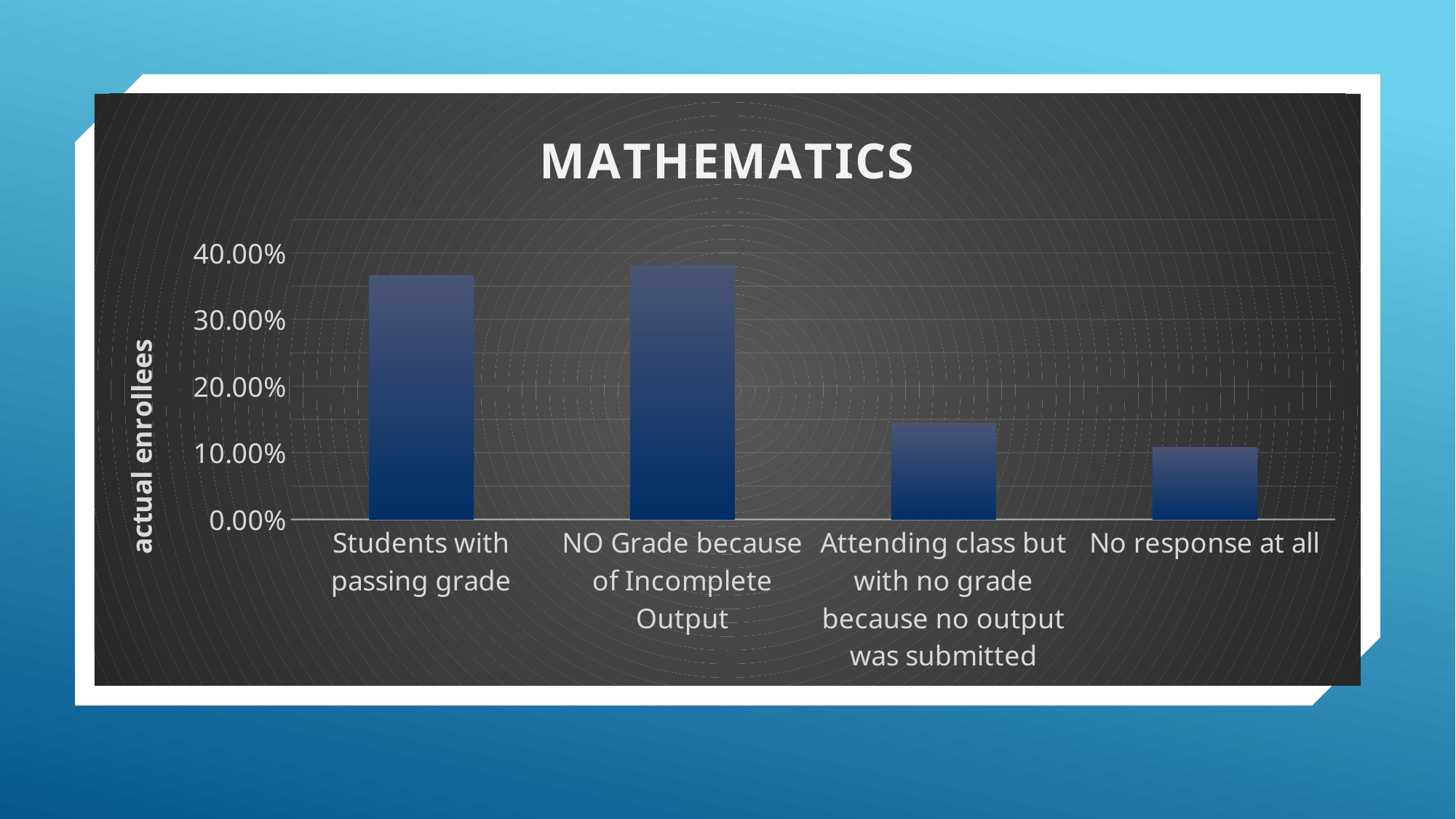
Is the value for Students with passing grade greater or less than 30.00%? greater What is the title of the chart? MATHEMATICS Is the value for Attending class but with no grade because no output was submitted greater or less than 20.00%? less What kind of chart is shown on the slide? bar chart How many categories are shown on the x axis of the chart? 4 What is the label on the vertical axis of the chart? actual enrollees Which category has the highest value? NO Grade because of Incomplete Output Is the value for NO Grade because of Incomplete Output greater or less than 40.00%? less Which is larger: the value for Attending class but with no grade because no output was submitted or the value for No response at all? Attending class but with no grade because no output was submitted Which is larger: the value for Students with passing grade or the value for Attending class but with no grade because no output was submitted? Students with passing grade Which category has the lowest value? No response at all